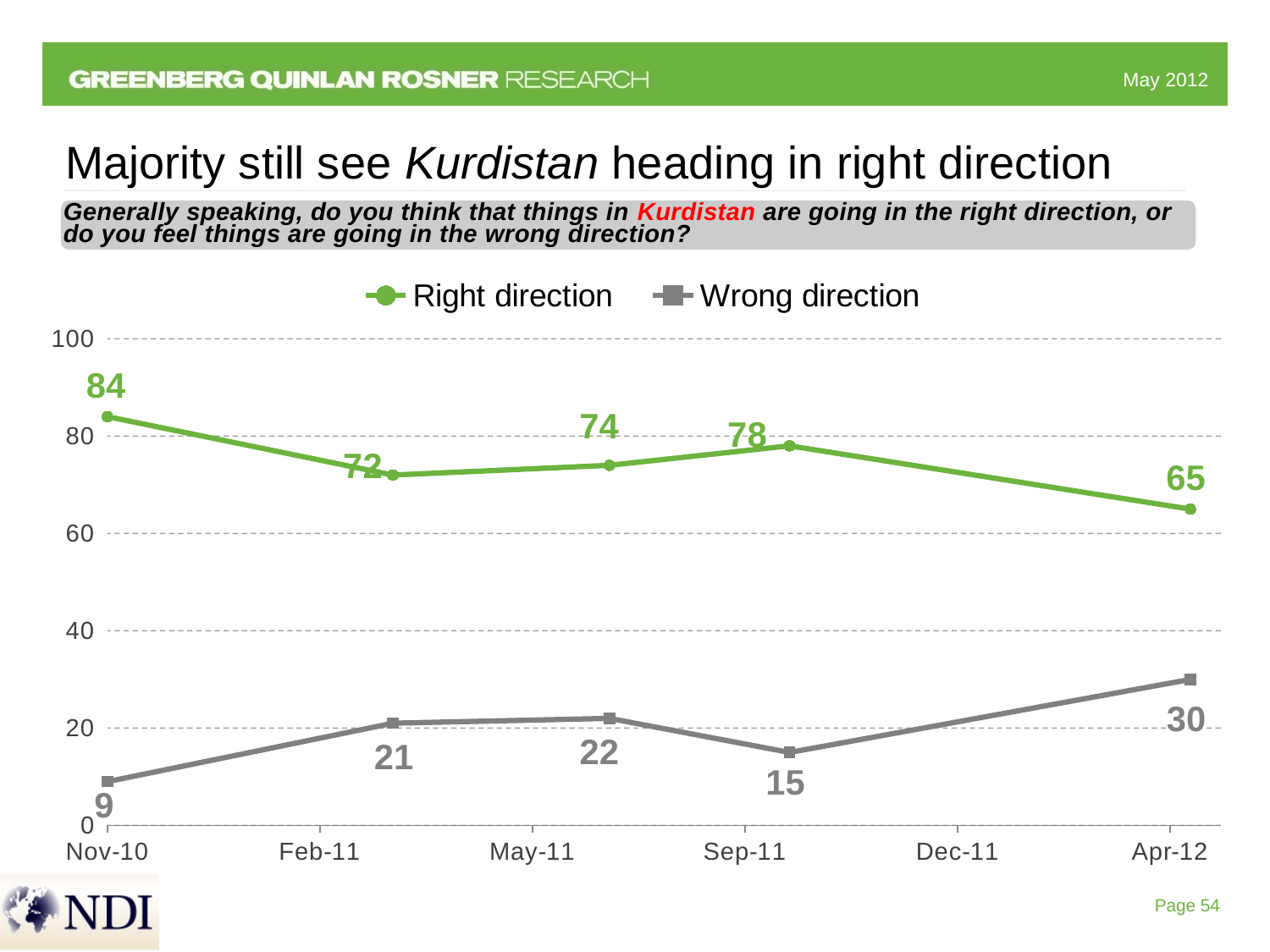
What type of chart is shown on the slide? line chart Is the value of Wrong direction at Nov-10 greater or less than 20? less Which series has the higher value at Nov-10, Right direction or Wrong direction? Right direction What is the highest value on the Wrong direction line? 30 What is the difference between Right direction and Wrong direction at Apr-12? 35 What is the lowest value on the Right direction line? 65 Does the Wrong direction line rise or fall overall from Nov-10 to Apr-12? rise What is the difference between the first and last values of the Right direction line? 19 What is the value of Wrong direction at Apr-12? 30 How many series does the legend list? 2 What is the value of Right direction at Nov-10? 84 How many data points does the Right direction line have? 5